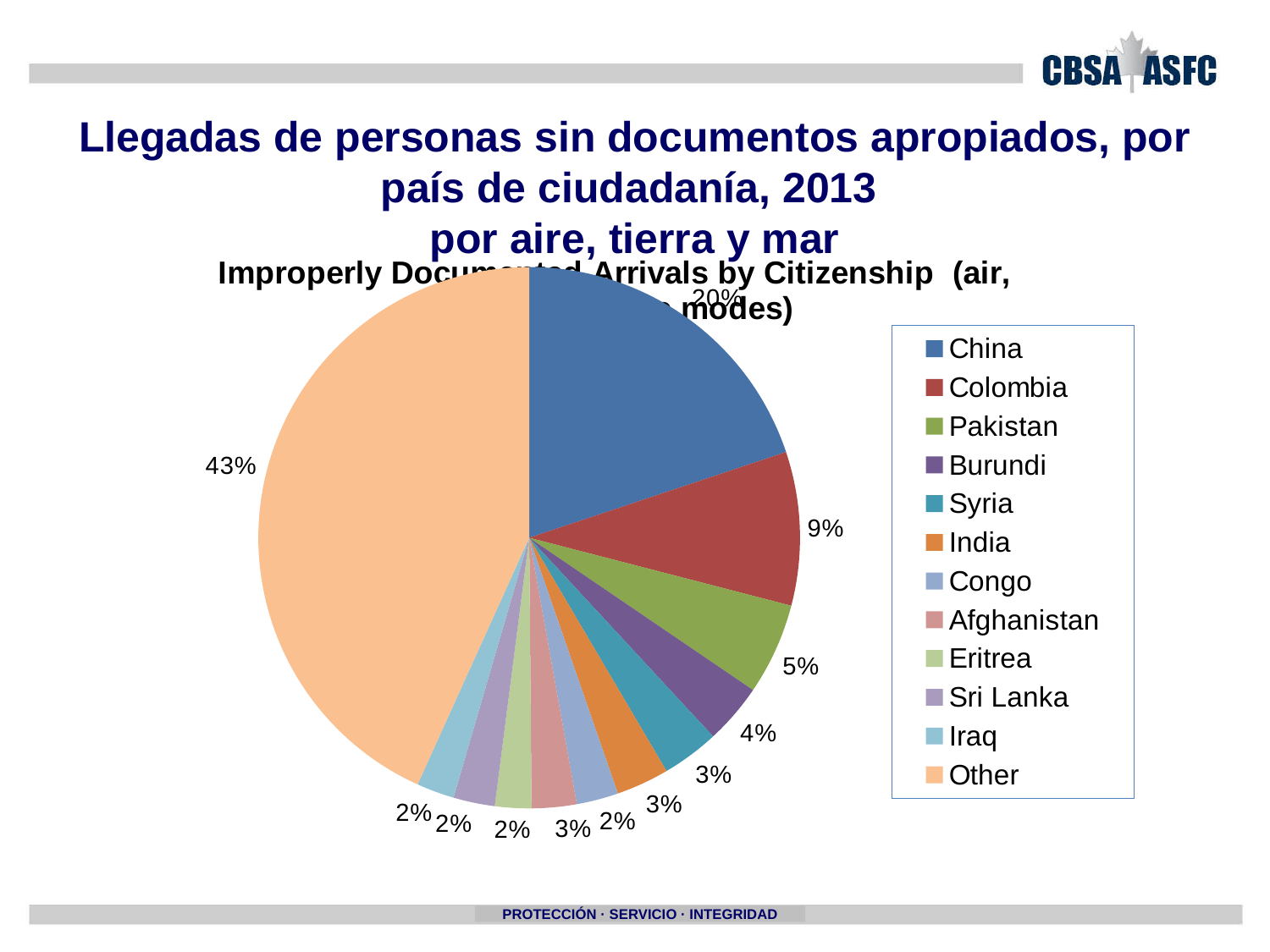
What is the difference in percentage points between China and Colombia? 11% What share of the pie does China represent? 20% What percentage is shown for Burundi? 4% Which category has the largest slice of the pie? Other Which named country (excluding Other) has the largest slice? China What percentage is shown for Pakistan? 5% What colour is the slice for Other? peach (light orange) How many categories does the legend list? 12 What percentage is shown for Colombia? 9% What type of chart is shown on the slide? pie chart What share of the pie is labelled Other? 43% Which is larger, the slice for Pakistan or the slice for Burundi? Pakistan